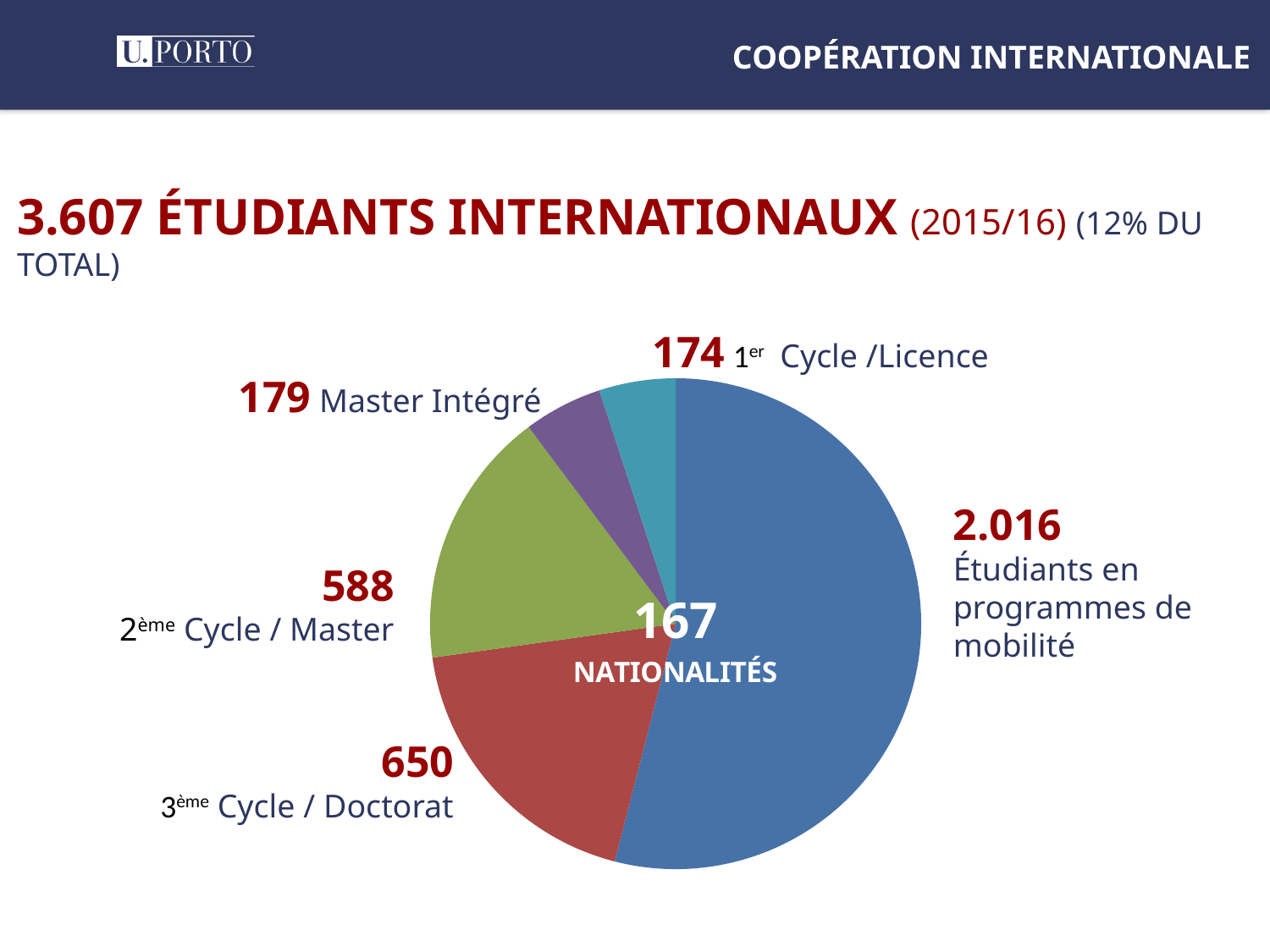
Which category has the largest slice in the pie chart? Étudiants en programmes de mobilité What is the difference between the values for Master Intégré and 1er Cycle / Licence? 5 What is the value for Master Intégré in the pie chart? 179 What is the value for 3ème Cycle / Doctorat in the pie chart? 650 What is the value for 2ème Cycle / Master in the pie chart? 588 Which is larger in the pie chart: 3ème Cycle / Doctorat or 2ème Cycle / Master? 3ème Cycle / Doctorat How many students are in mobility programmes (Étudiants en programmes de mobilité) according to the pie chart? 2.016 What number is written in the centre of the pie chart, and what does it refer to? 167 nationalités What is the value for 1er Cycle / Licence in the pie chart? 174 What kind of chart is shown on the slide? pie chart What is the difference between the values for 3ème Cycle / Doctorat and 2ème Cycle / Master? 62 How many slices does the pie chart have? 5